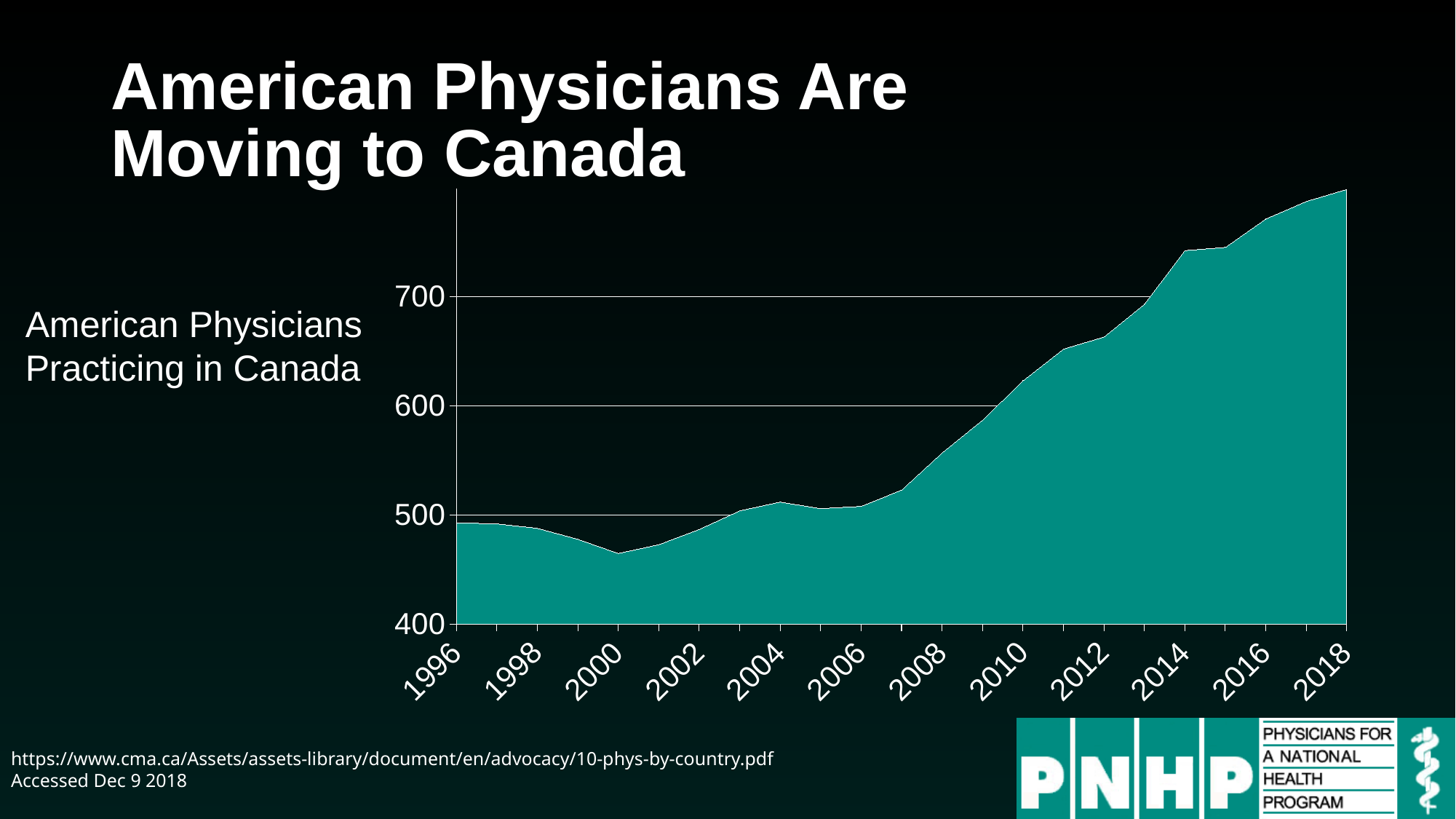
Is the value for 2010 greater or less than 600? greater How many year labels are shown on the x axis? 12 What is the title of the chart on the slide? American Physicians Practicing in Canada Is the value for 2014 greater or less than 700? greater Which is larger, the value for 1996 or the value for 2018? 2018 Is the value for 2008 greater or less than 600? less Which year shown on the x axis has the highest value? 2018 What kind of chart is shown on the slide? Area chart Which year shown on the x axis has the lowest value? 2000 Overall, do the values rise or fall from 2000 to 2018? rise